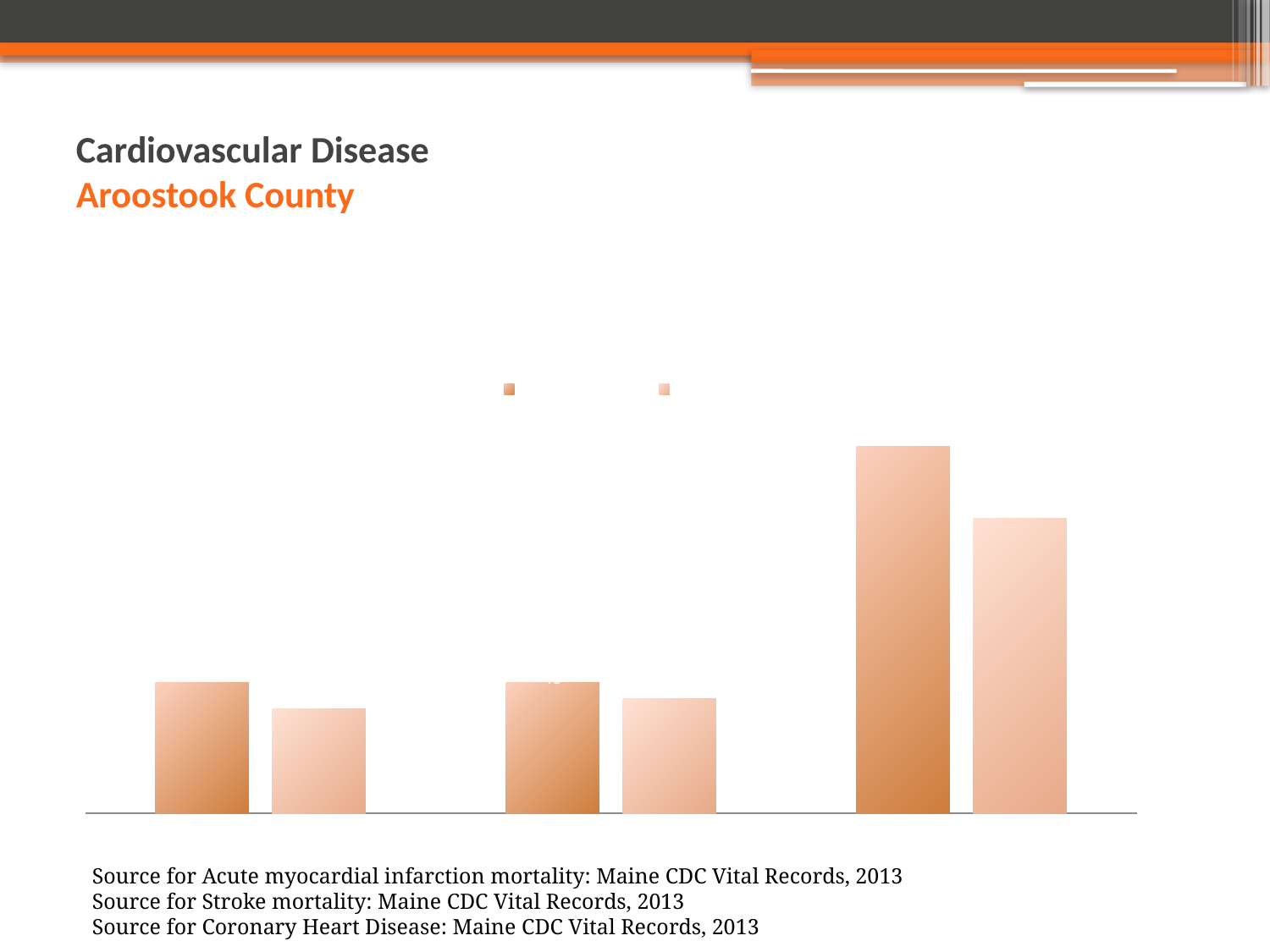
Which county does the slide's chart refer to? Aroostook County Which group of bars, by position from left to right, has the tallest bars? the rightmost group What kind of chart is shown on the slide? bar chart In the rightmost group of bars, is the darker bar or the lighter bar taller? the darker bar How many groups of bars are plotted in the chart? 3 In the leftmost group of bars, is the darker bar or the lighter bar taller? the darker bar What is the main title of the slide above the chart? Cardiovascular Disease How many series does the chart's legend show? 2